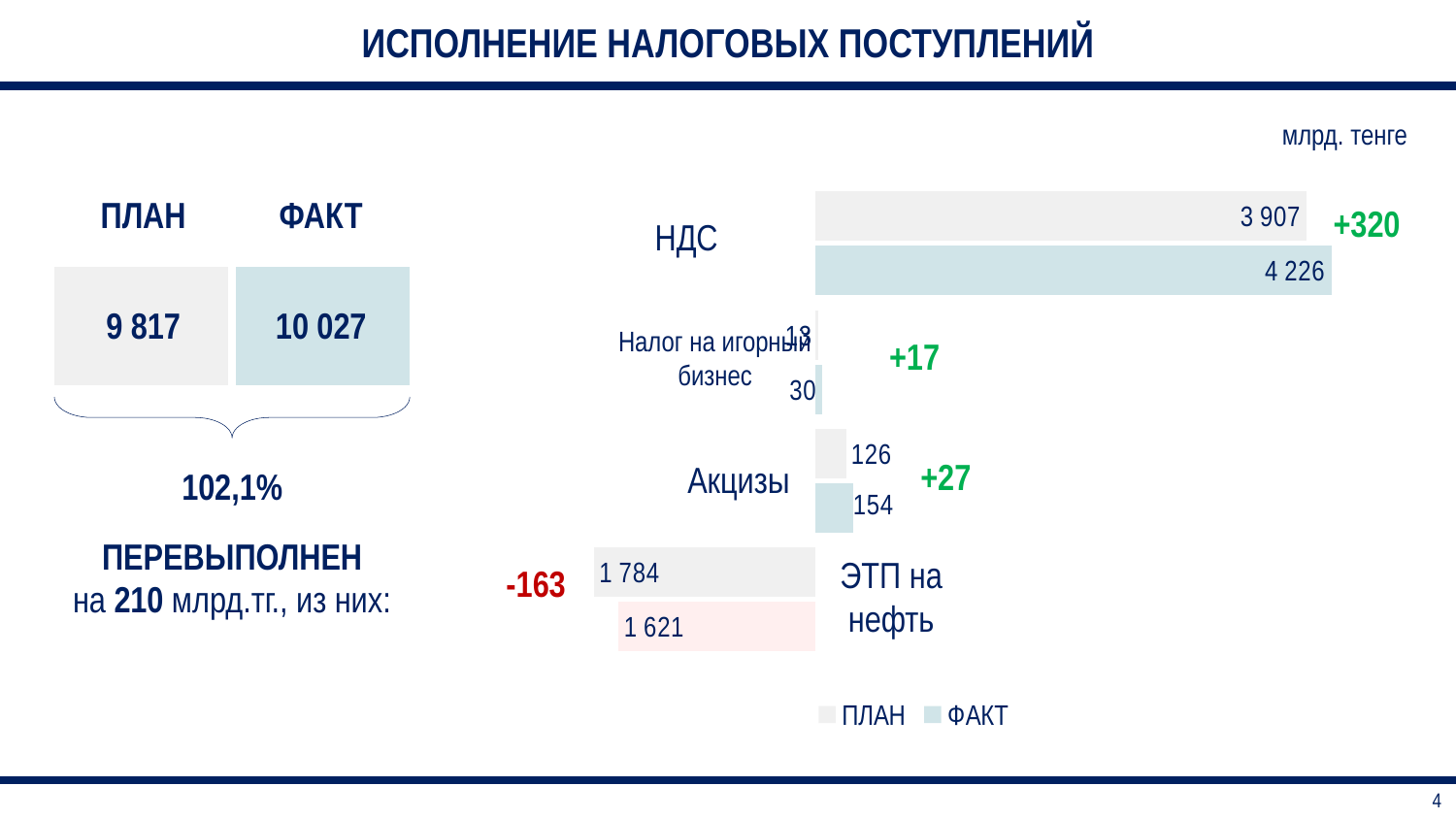
Which category has the highest ФАКТ value? НДС What is the ФАКТ value for НДС? 4 226 What is the ФАКТ value for ЭТП на нефть? 1 621 What is the ФАКТ value for Акцизы? 154 What is the ПЛАН value for НДС? 3 907 What kind of chart is shown on the right of the slide? bar chart For ЭТП на нефть, which is larger: ПЛАН or ФАКТ? ПЛАН By how much does the ФАКТ value for ЭТП на нефть fall short of the ПЛАН value? 163 How many series does the legend list? 2 Which category has the lowest ФАКТ value? Налог на игорный бизнес What is the ПЛАН value for ЭТП на нефть? 1 784 How many categories are shown in the bar chart? 4